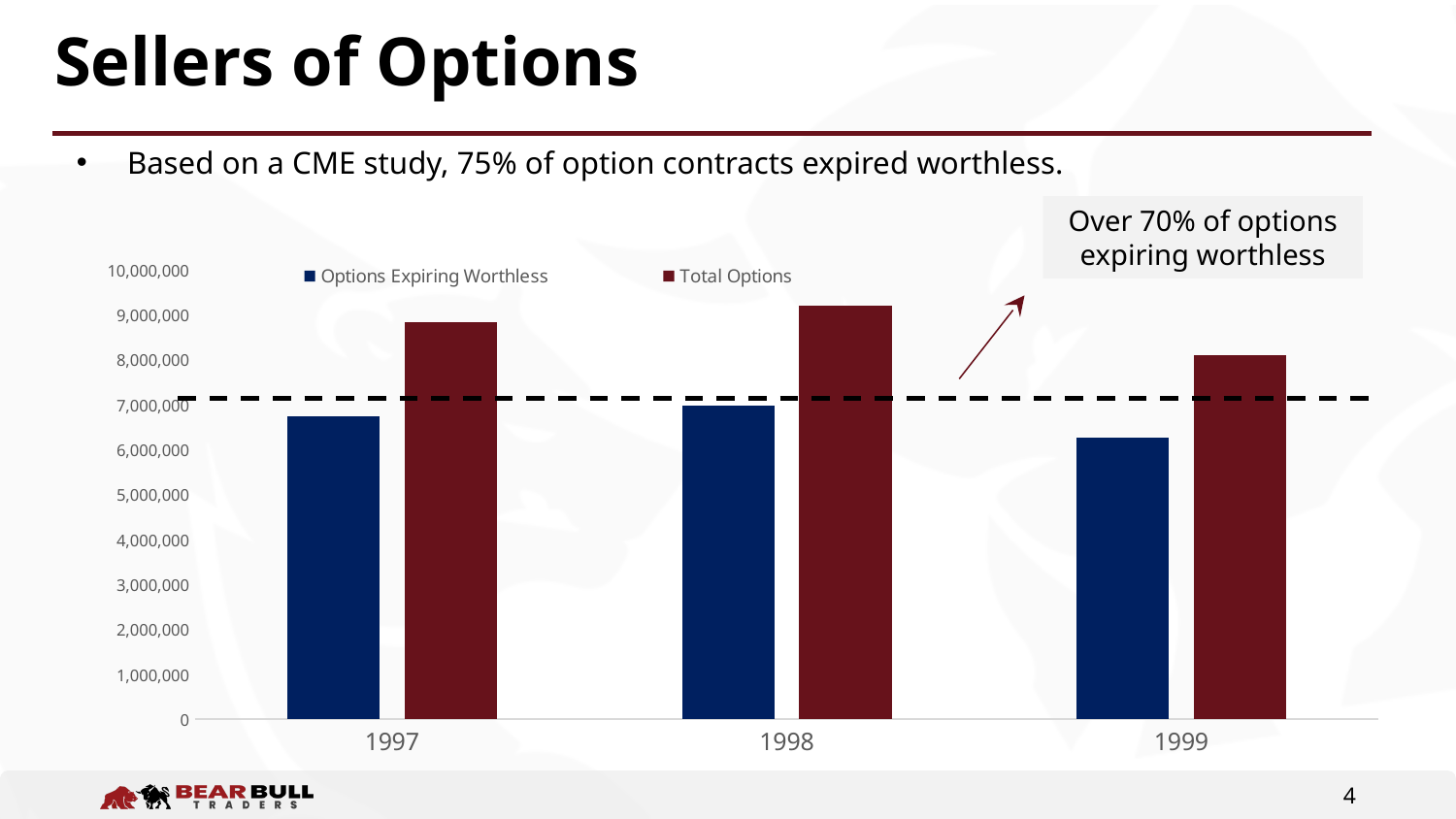
What kind of chart is shown on the slide? bar chart Which is larger: Total Options in 1997 or Total Options in 1999? 1997 Which year has the lowest Options Expiring Worthless bar? 1999 Is the Total Options value for 1998 greater or less than 9,000,000? greater Which year has the lowest Total Options bar? 1999 Which colour represents the Total Options series in the chart? dark red How many series does the chart legend list? 2 Is the Options Expiring Worthless value for 1999 greater or less than 7,000,000? less How many years are shown on the x axis of the chart? 3 What are the two series named in the chart legend? Options Expiring Worthless and Total Options Is the Total Options value for 1997 greater or less than 8,000,000? greater Which year has the highest Total Options bar? 1998